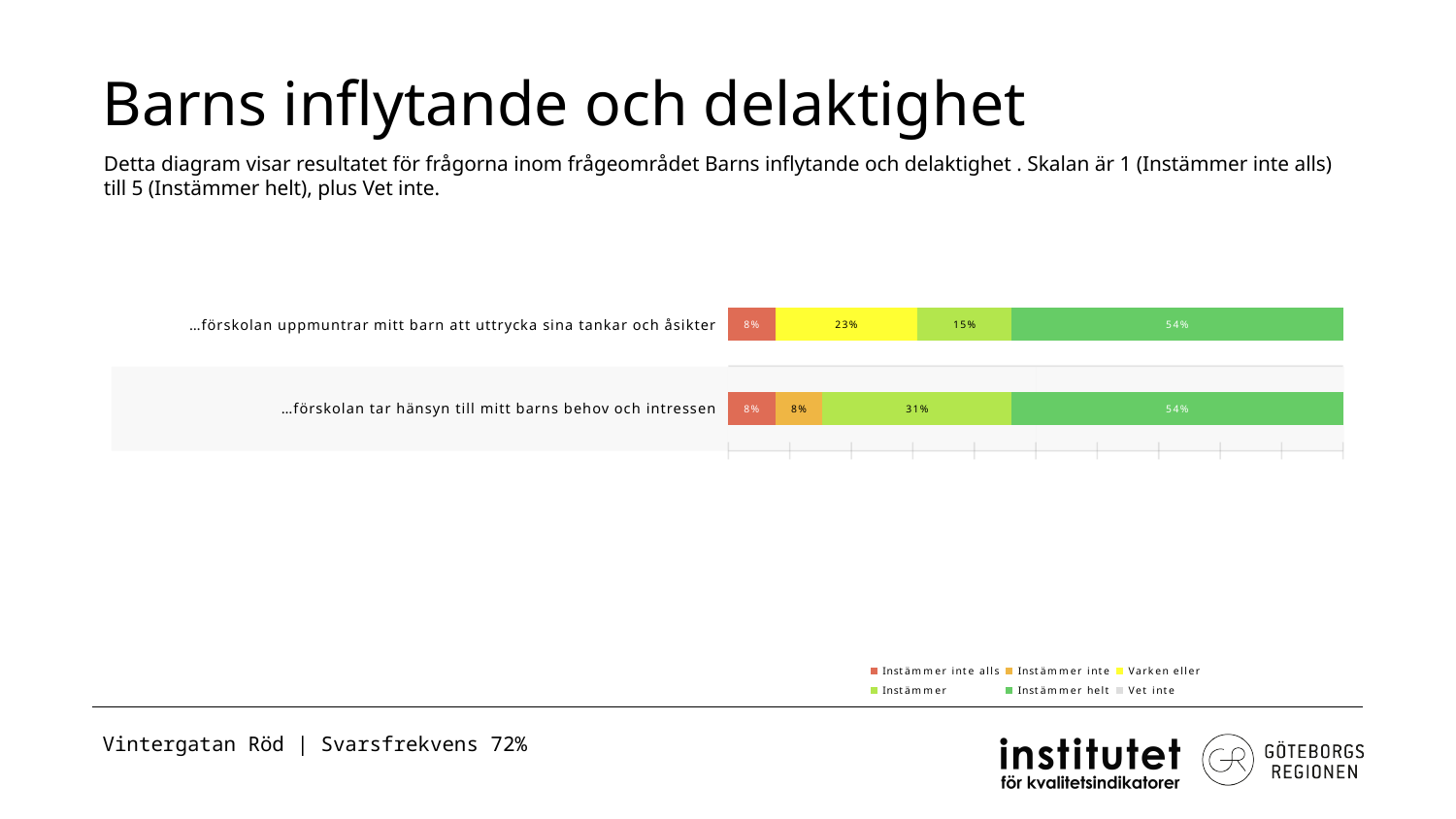
Which statement has the larger 'Instämmer' share: '…förskolan uppmuntrar mitt barn att uttrycka sina tankar och åsikter' or '…förskolan tar hänsyn till mitt barns behov och intressen'? …förskolan tar hänsyn till mitt barns behov och intressen What kind of chart is shown on the slide? Stacked bar chart What is the 'Instämmer' value for '…förskolan tar hänsyn till mitt barns behov och intressen'? 31% What is the 'Instämmer inte alls' value for '…förskolan tar hänsyn till mitt barns behov och intressen'? 8% Which legend entry is shown in dark green? Instämmer helt What is the 'Instämmer helt' value for '…förskolan uppmuntrar mitt barn att uttrycka sina tankar och åsikter'? 54% How many statements (categories) are plotted in the chart? 2 What is the 'Instämmer' value for '…förskolan uppmuntrar mitt barn att uttrycka sina tankar och åsikter'? 15% What is the difference between the 'Instämmer' values of the two statements (31% and 15%)? 16% What is the title of the slide containing the chart? Barns inflytande och delaktighet What is the 'Varken eller' value for '…förskolan uppmuntrar mitt barn att uttrycka sina tankar och åsikter'? 23% How many series does the chart legend list? 6